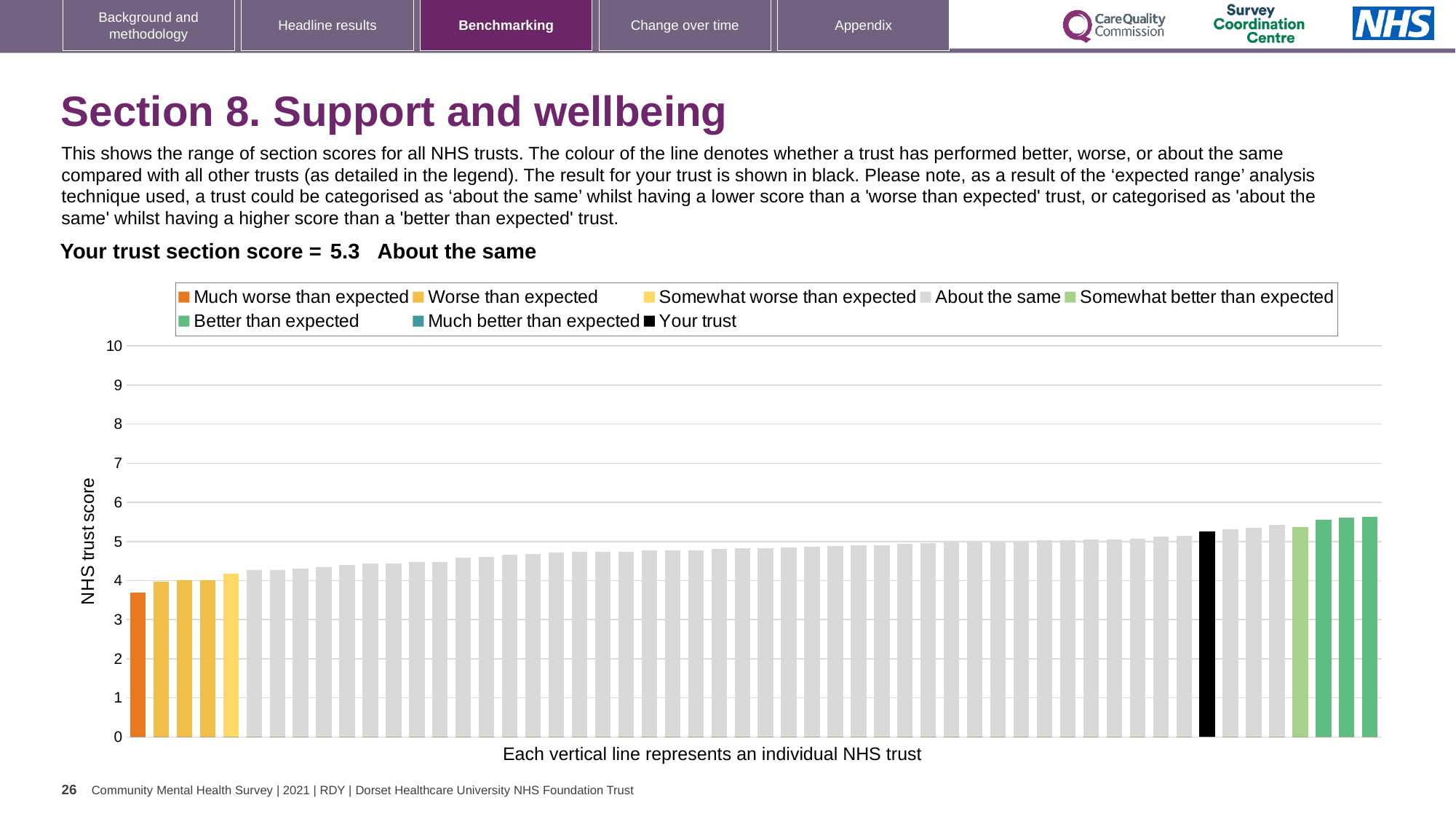
Is the tallest bar on the chart greater or less than 6? less Do the bar values rise or fall from left to right along the x axis? rise Which is larger: the value for your trust or the value for the 'Much worse than expected' trust? your trust Which legend category does the tallest bar belong to? Better than expected How many entries does the chart legend list? 8 What is the section score for your trust? 5.3 Is the value for your trust (the black bar) greater or less than 5? greater What kind of chart is shown on the slide? bar chart Which legend category does the shortest bar belong to? Much worse than expected What is the label on the vertical axis of the chart? NHS trust score How many bars are coloured as 'Better than expected'? 3 Is the value for the 'Much worse than expected' trust greater or less than 4? less